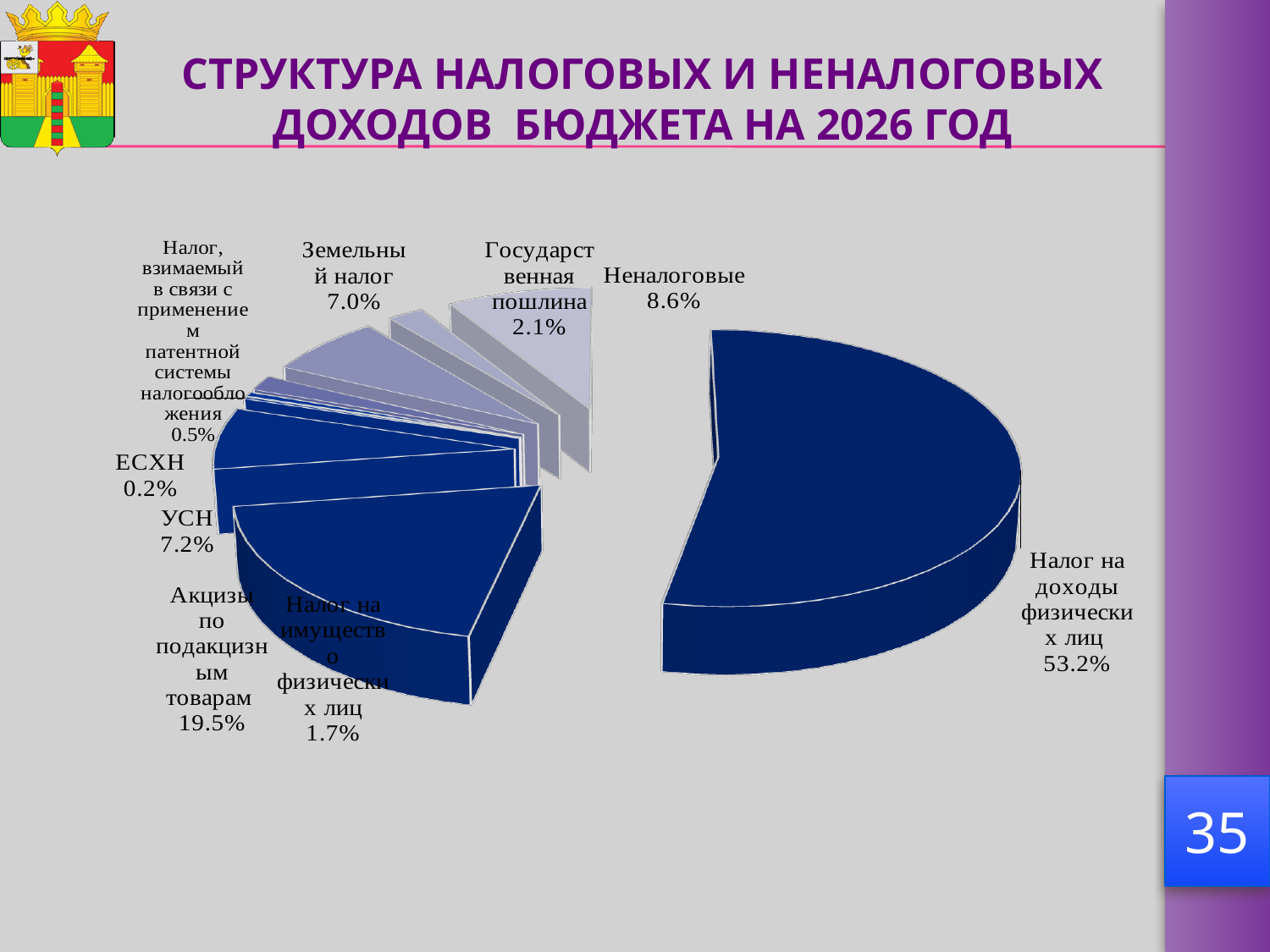
Which category has the smallest share of the pie? ЕСХН What is the value shown for "Акцизы по подакцизным товарам"? 19.5% What is the value shown for "Земельный налог"? 7.0% Which is larger, the share of "Неналоговые" or the share of "УСН"? Неналоговые What is the title of the slide containing the chart? СТРУКТУРА НАЛОГОВЫХ И НЕНАЛОГОВЫХ ДОХОДОВ БЮДЖЕТА НА 2026 ГОД What is the difference between the shares of "УСН" and "Земельный налог"? 0.2% Which category has the largest share of the pie? Налог на доходы физических лиц How many slices does the pie chart have? 9 What share of the pie does "Налог на доходы физических лиц" have? 53.2% What kind of chart is shown on the slide? Pie chart What is the value shown for "Государственная пошлина"? 2.1% What is the value shown for "Неналоговые"? 8.6%